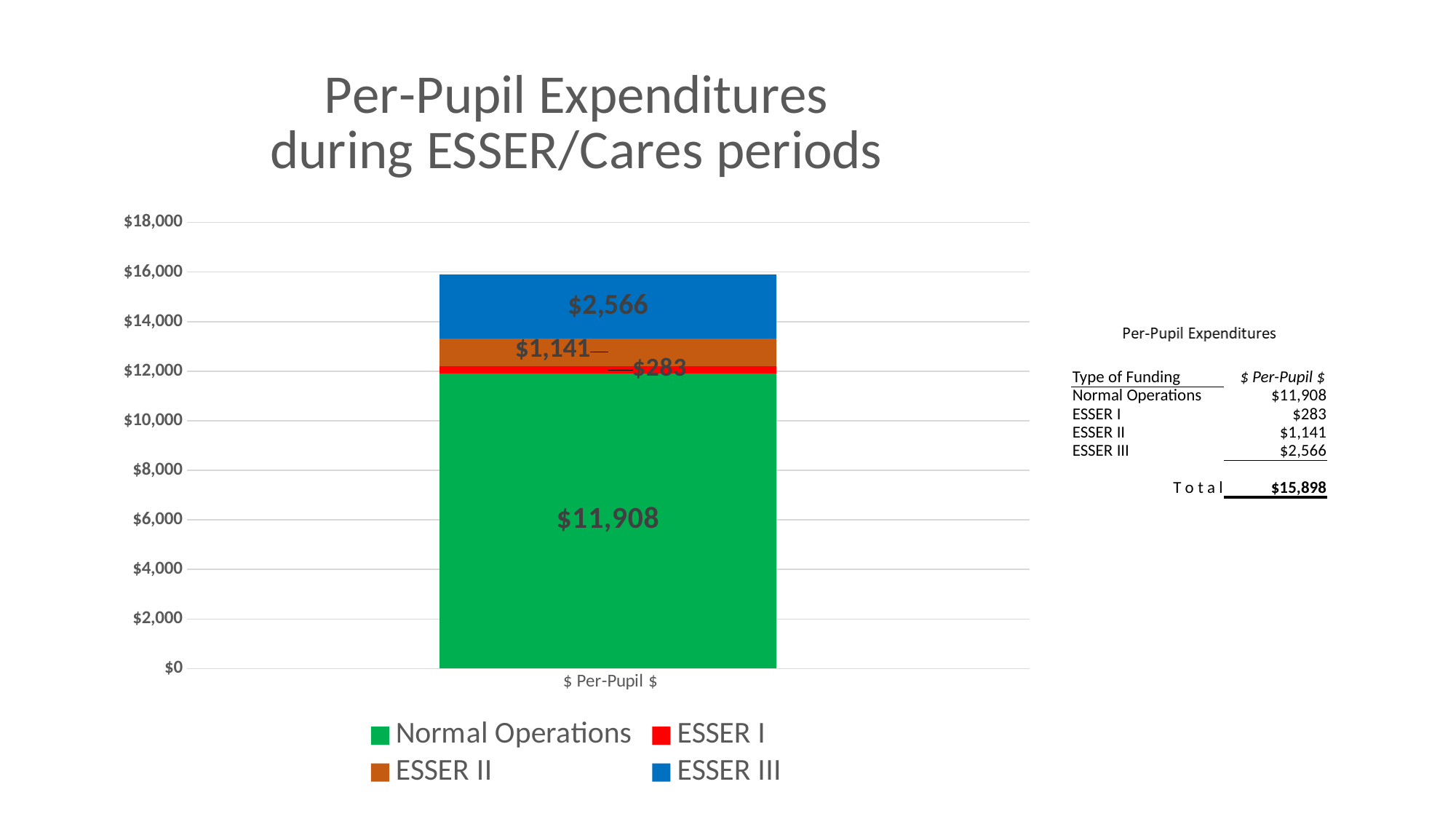
What is the value of the ESSER II segment in the stacked bar? $1,141 Which series has the smallest segment in the stacked bar? ESSER I What is the difference between the ESSER III and ESSER II segments? $1,425 Which series has the largest segment in the stacked bar? Normal Operations How many series does the legend list? 4 What colour represents ESSER III in the chart? Blue What is the value of the Normal Operations segment in the stacked bar? $11,908 What kind of chart is shown on the slide? Stacked bar chart What is the value of the ESSER I segment in the stacked bar? $283 What is the total of the stacked bar? $15,898 What is the value of the ESSER III segment in the stacked bar? $2,566 Which is larger, the ESSER II segment or the ESSER I segment? ESSER II